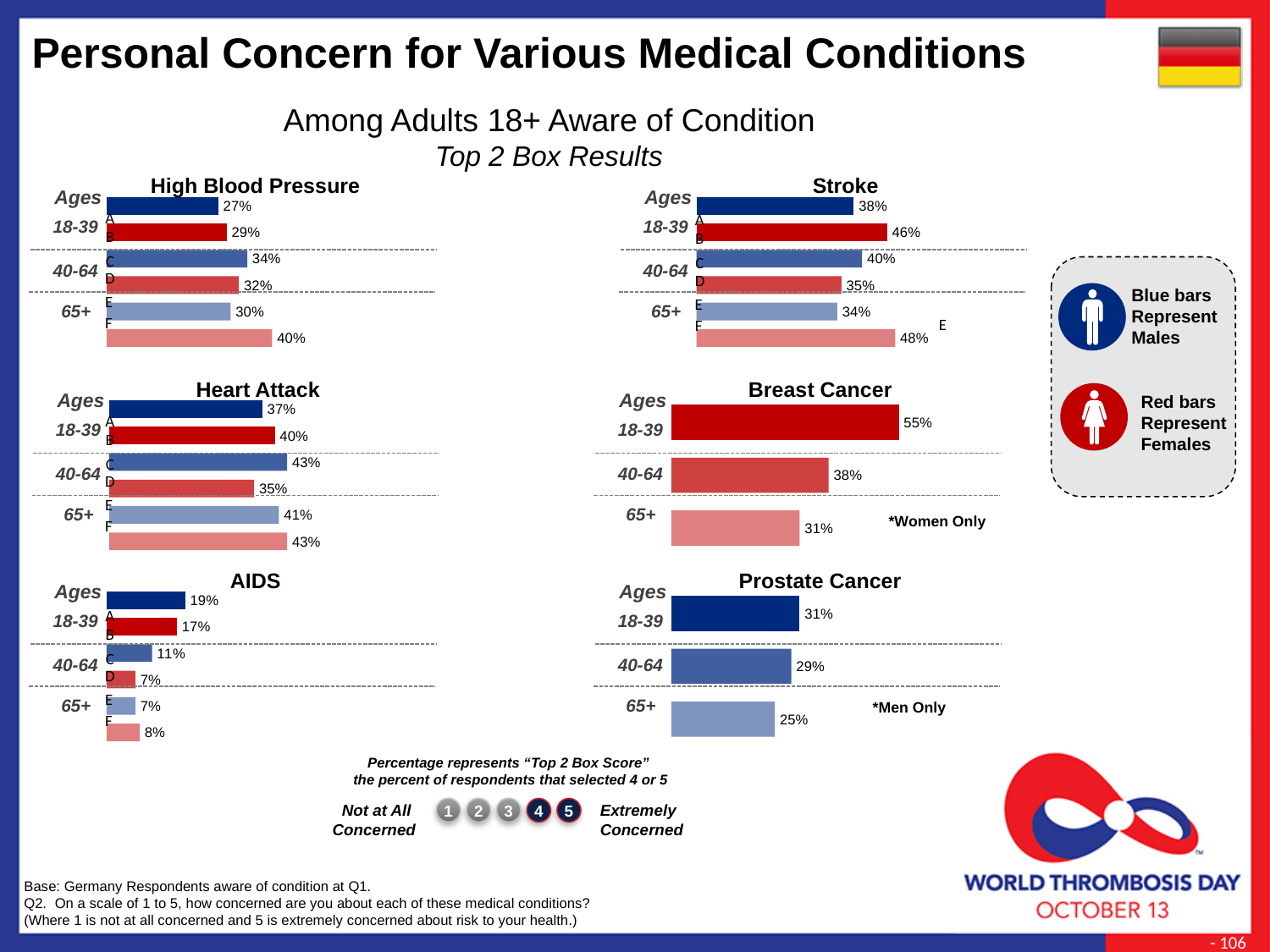
In the Heart Attack chart, which age group has the highest value for males? 40-64 In the High Blood Pressure chart, what is the value for females aged 65+? 40% In the Breast Cancer chart, which age group has the lowest value? 65+ In the Prostate Cancer chart, do the values rise or fall as age increases? Fall In the Breast Cancer chart, what is the difference between the 18-39 and 65+ values? 24% According to the legend, what do the blue bars represent? Males How many age groups are shown in the Prostate Cancer chart? 3 What type of chart is used for the Heart Attack data? Bar chart In the Prostate Cancer chart, what is the value for ages 40-64? 29% In the AIDS chart, what is the difference between the male and female values for ages 18-39? 2% In the Stroke chart, which is larger for ages 65+: the male value or the female value? Female (48%) In the Stroke chart, what is the value for males aged 18-39? 38%